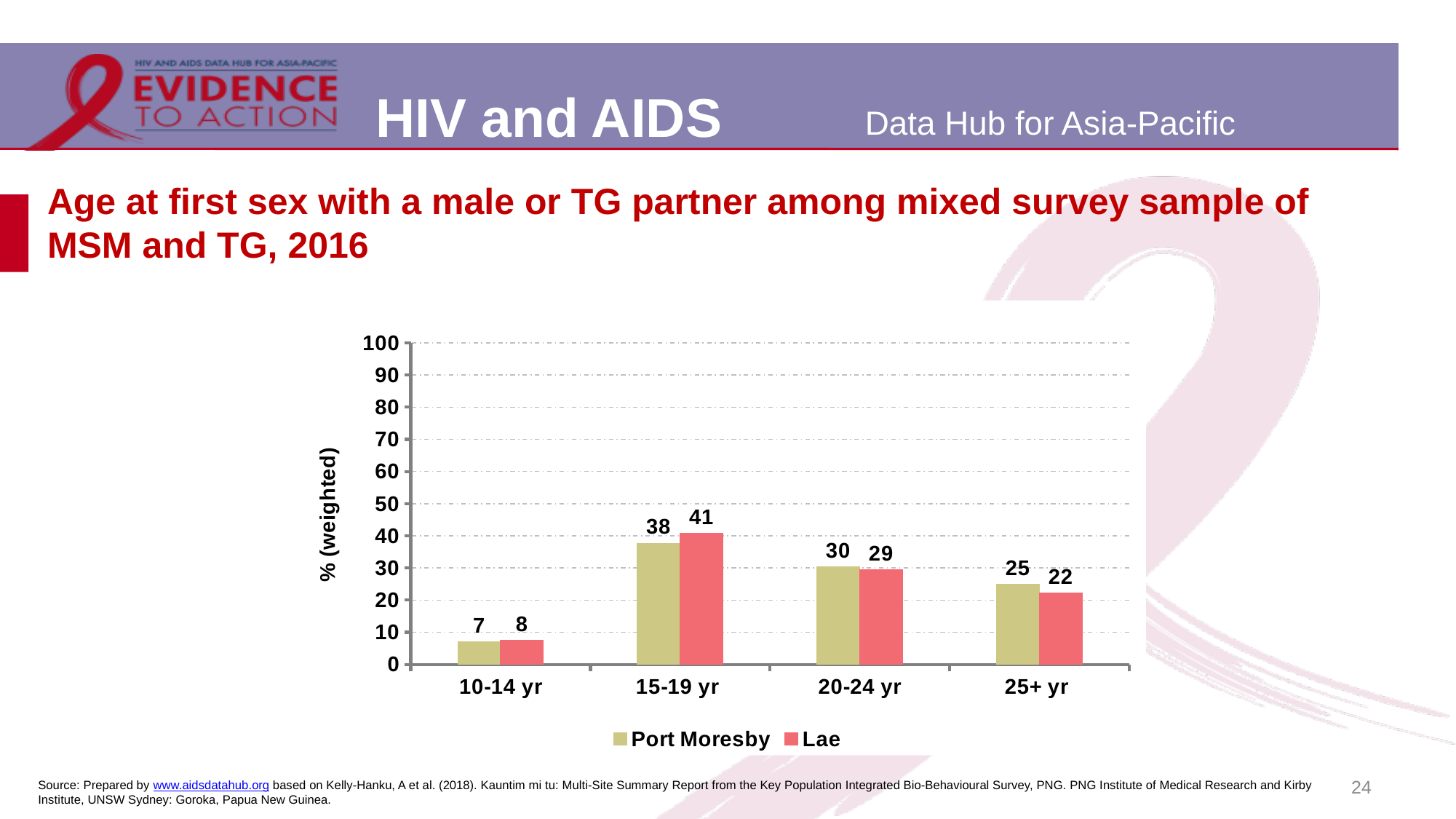
In the 25+ yr age group, which is larger: Port Moresby or Lae? Port Moresby What is the label of the y axis? % (weighted) What is the value for Port Moresby in the 15-19 yr age group? 38 Which age group has the lowest value for Port Moresby? 10-14 yr What is the difference between the Lae and Port Moresby values in the 15-19 yr age group? 3 What is the value for Lae in the 25+ yr age group? 22 Which age group has the highest value for Lae? 15-19 yr Is the value for Port Moresby in the 20-24 yr age group greater or less than 20? greater How many age groups are shown on the x axis? 4 What is the value for Lae in the 10-14 yr age group? 8 How many series does the legend list? 2 What kind of chart is shown on the slide? Bar chart